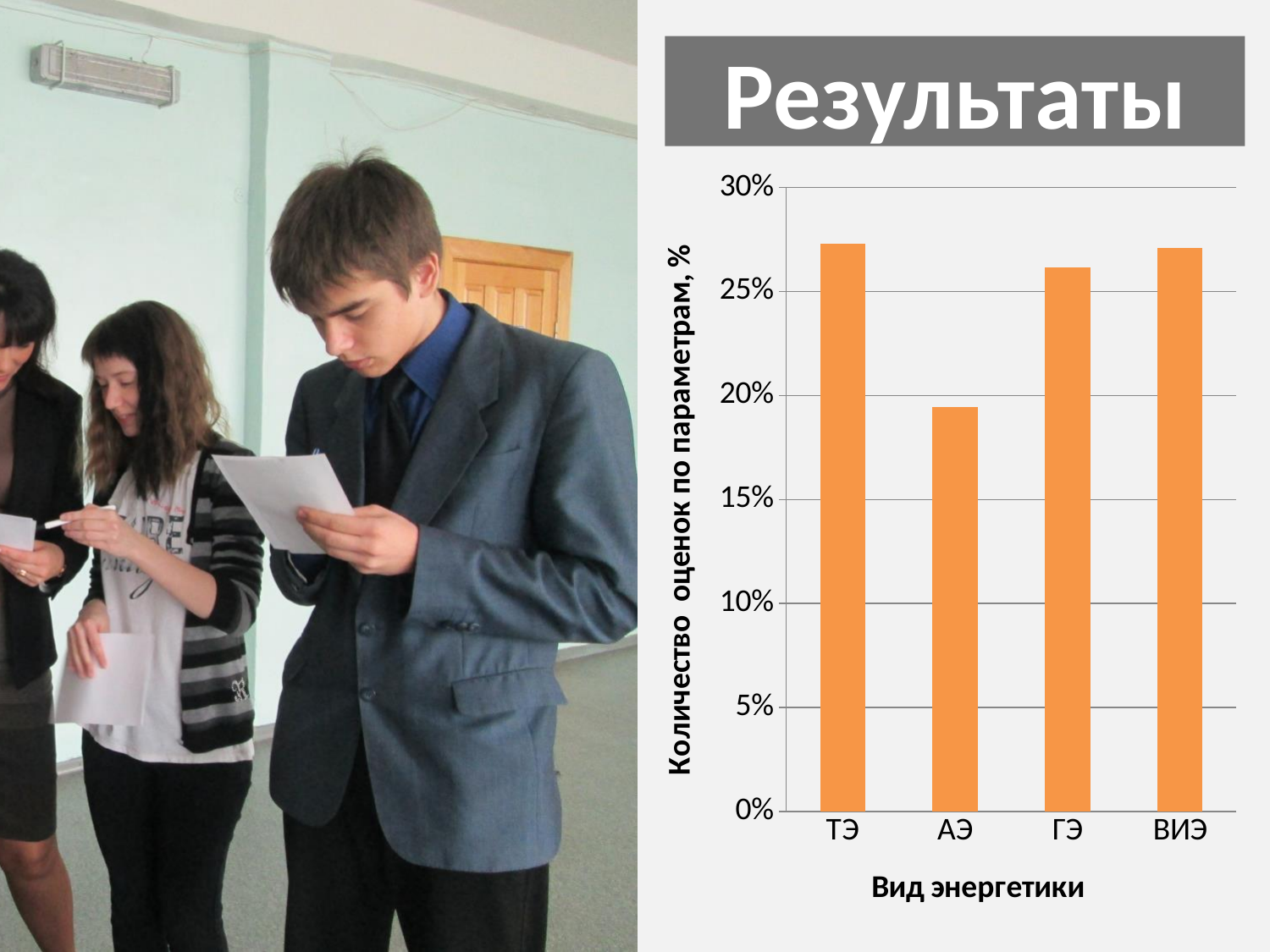
What is the title of the x axis of the chart? Вид энергетики Which is larger, the value for ГЭ or the value for АЭ? ГЭ Is the value for ГЭ greater or less than 25%? greater What kind of chart is shown on the slide? bar chart How many categories are shown on the x axis of the chart? 4 Is the value for АЭ greater or less than 15%? greater Which category has the lowest value in the chart? АЭ Which is larger, the value for ТЭ or the value for АЭ? ТЭ Is the value for ВИЭ greater or less than 30%? less What is the title shown above the chart? Результаты